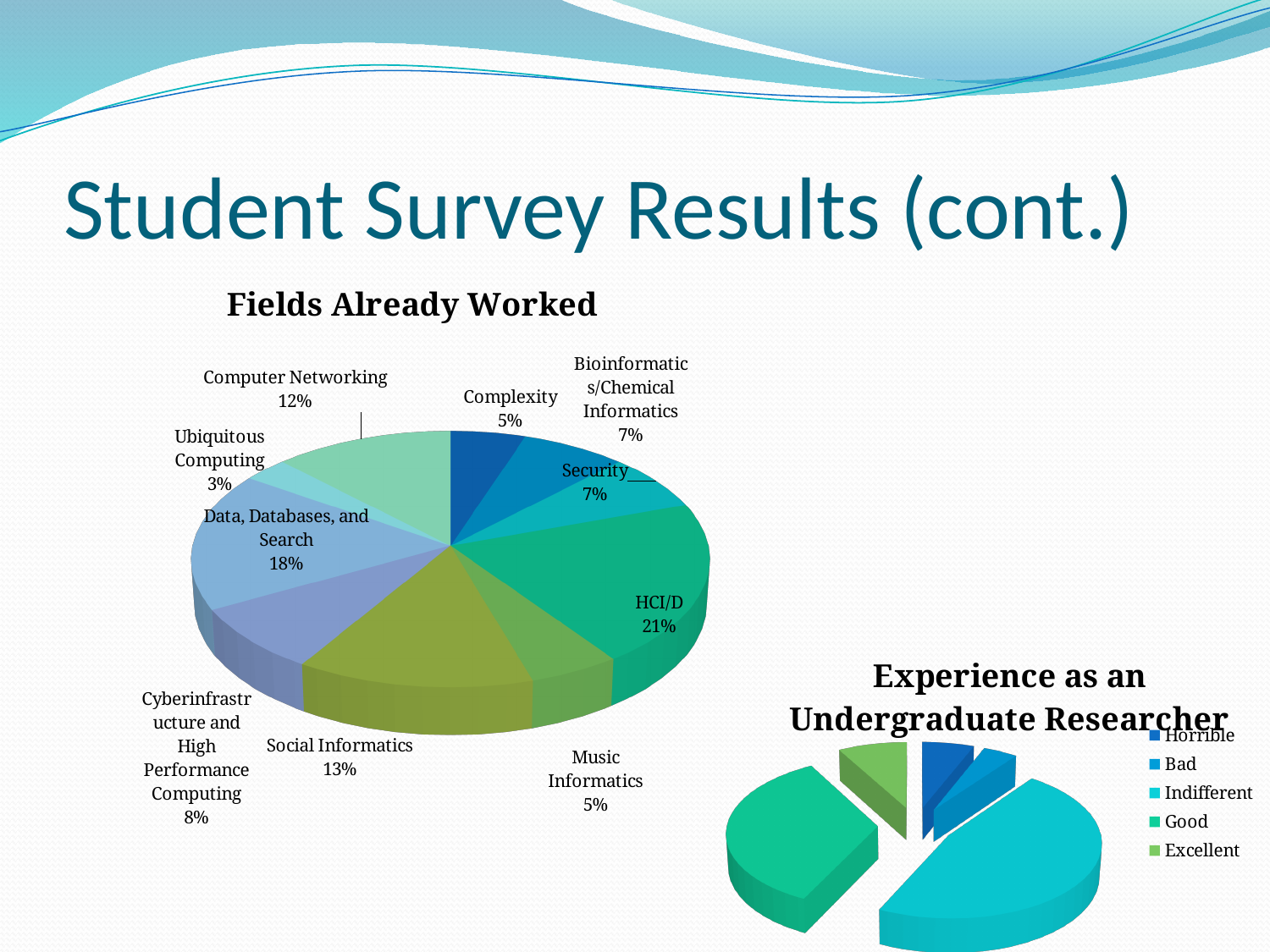
In the 'Fields Already Worked' chart, what is the difference between the shares for HCI/D and Social Informatics? 8% In the 'Fields Already Worked' chart, which has a larger share: Computer Networking or Cyberinfrastructure and High Performance Computing? Computer Networking In the 'Fields Already Worked' chart, what percentage is shown for Ubiquitous Computing? 3% In the 'Fields Already Worked' chart, which field has the smallest share? Ubiquitous Computing How many entries does the legend of the 'Experience as an Undergraduate Researcher' chart list? 5 What is the title of the chart in the lower right of the slide? Experience as an Undergraduate Researcher In the 'Experience as an Undergraduate Researcher' chart, which slice is larger: Horrible or Indifferent? Indifferent In the 'Fields Already Worked' chart, which field has the largest share? HCI/D In the 'Fields Already Worked' chart, what percentage is shown for Data, Databases, and Search? 18% How many fields are shown in the 'Fields Already Worked' chart? 10 In the 'Fields Already Worked' chart, what percentage is shown for HCI/D? 21% What type of chart is 'Fields Already Worked'? Pie chart